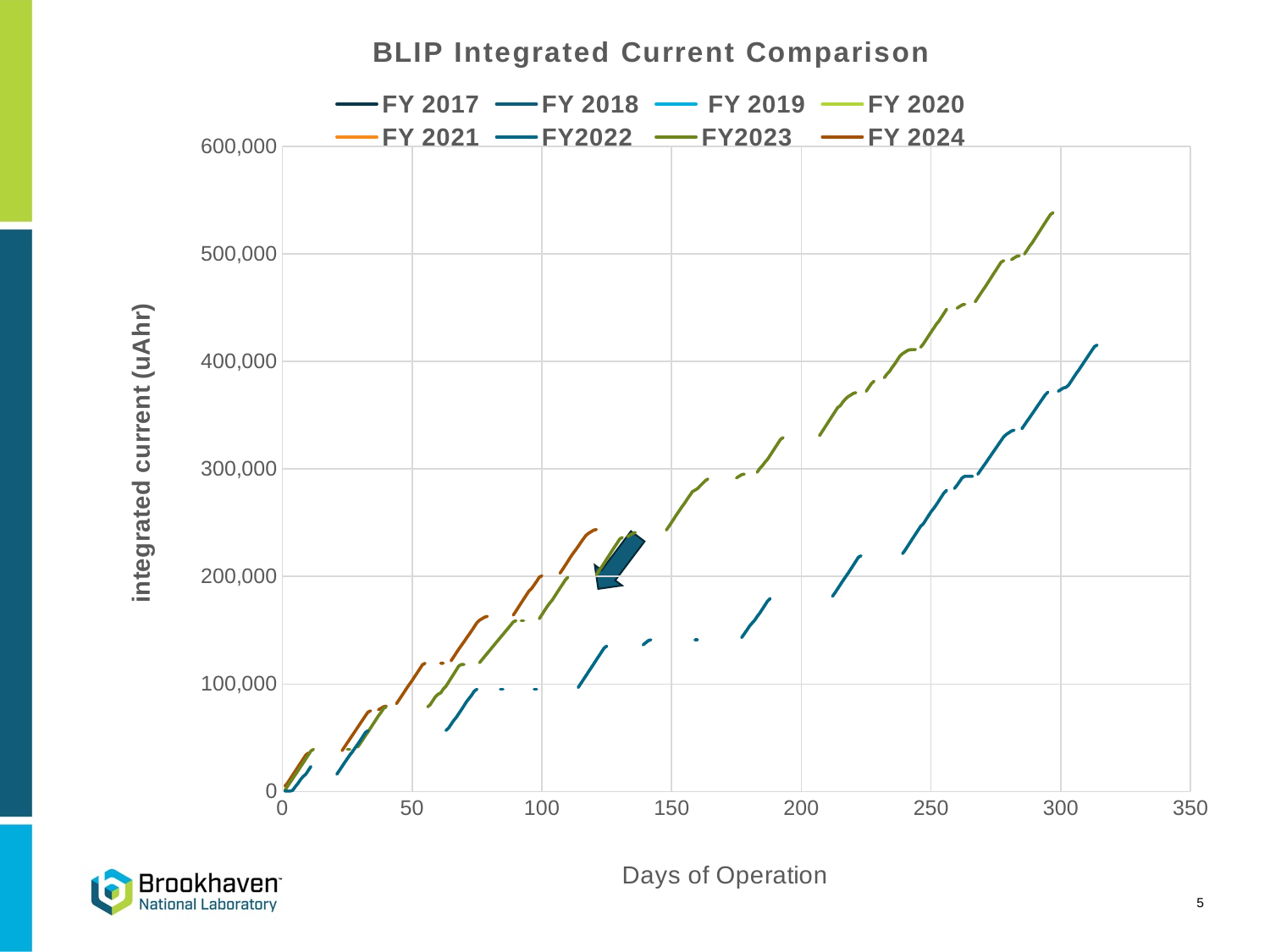
At 200 days of operation, which series has the larger integrated current, FY2023 or FY2022? FY2023 What is the title of the chart? BLIP Integrated Current Comparison Is the highest value reached by the FY2023 line greater or less than 500,000? greater Is the value for FY 2024 at 100 days of operation greater or less than 150,000? greater Is the value for FY2022 at 250 days of operation greater or less than 300,000? less What is the label of the x axis? Days of Operation Which series reaches the highest integrated current on the chart? FY2023 How many series does the legend list? 8 What kind of chart is shown on the slide? line chart Do the integrated current values rise or fall as days of operation increase? rise